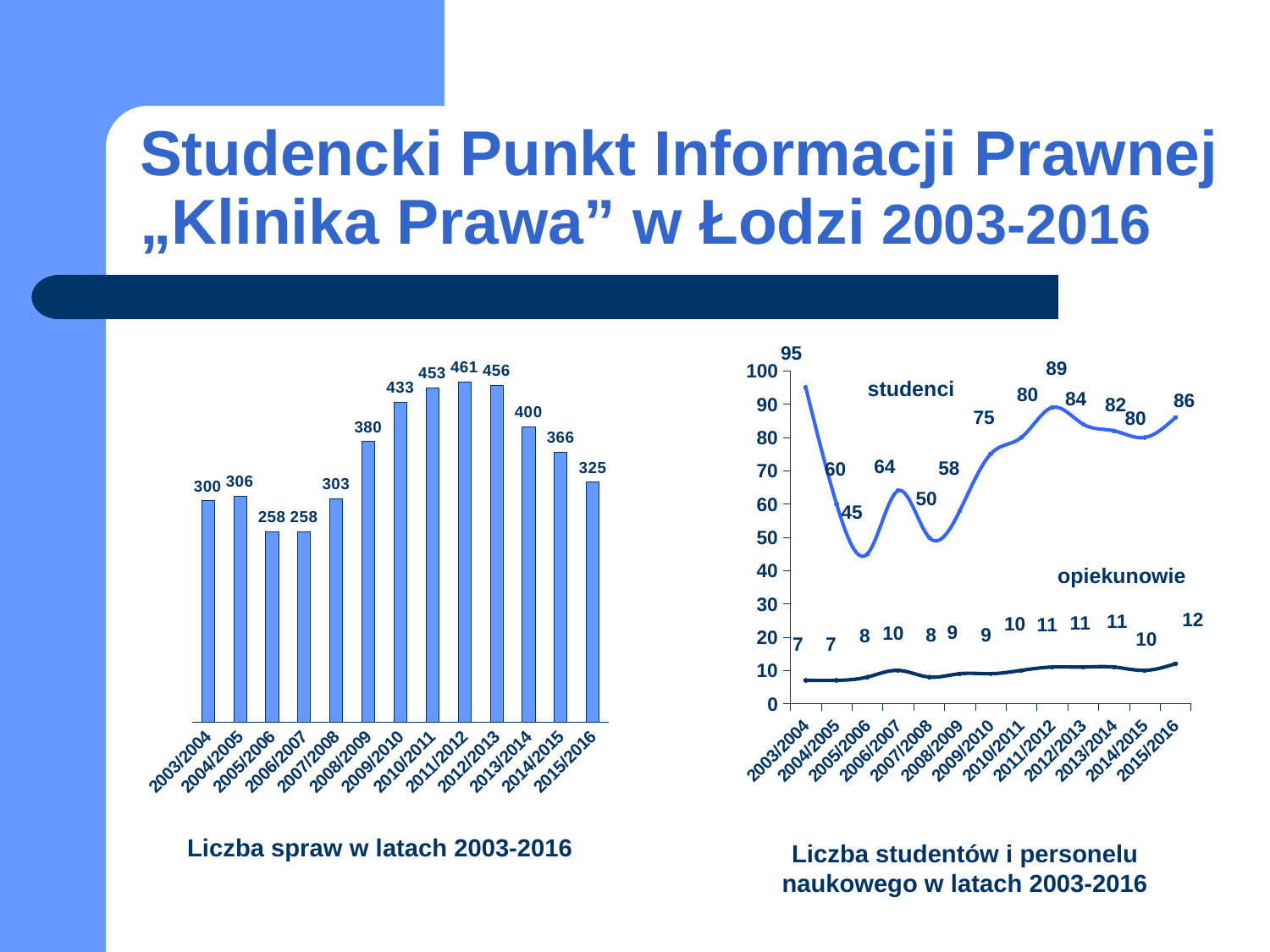
What kind of chart is the right chart (Liczba studentów i personelu naukowego)? Line chart In the right chart (Liczba studentów i personelu naukowego), in which year is the studenci value lowest? 2005/2006 In the right chart (Liczba studentów i personelu naukowego), which is larger: the studenci value in 2009/2010 or in 2007/2008? 2009/2010 In the left chart (Liczba spraw w latach 2003-2016), what is the value for 2011/2012? 461 In the left chart (Liczba spraw w latach 2003-2016), which year has the lowest number of cases? 2005/2006 and 2006/2007 (258) In the left chart (Liczba spraw w latach 2003-2016), do the values rise or fall from 2011/2012 to 2015/2016? Fall In the left chart (Liczba spraw w latach 2003-2016), what is the difference between the values for 2011/2012 and 2015/2016? 136 In the left chart (Liczba spraw w latach 2003-2016), how many years are shown on the x axis? 13 In the right chart (Liczba studentów i personelu naukowego), what is the difference between studenci and opiekunowie in 2015/2016? 74 What kind of chart is the left chart (Liczba spraw w latach 2003-2016)? Bar chart In the right chart (Liczba studentów i personelu naukowego), what is the value for opiekunowie in 2015/2016? 12 In the right chart (Liczba studentów i personelu naukowego), what is the value for studenci in 2003/2004? 95